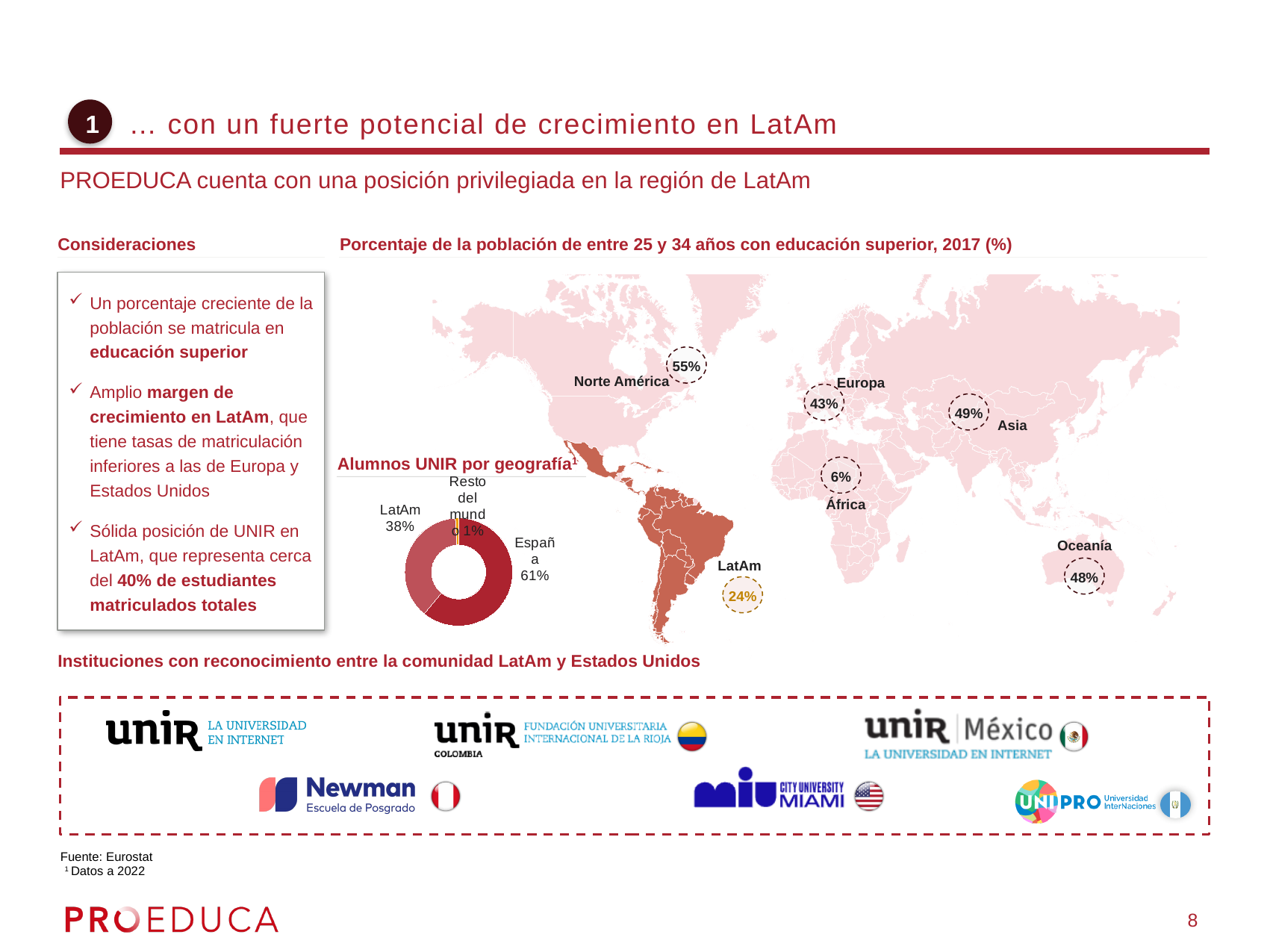
In the map 'Porcentaje de la población de entre 25 y 34 años con educación superior, 2017 (%)', which is higher, Europa or Asia? Asia In the 'Alumnos UNIR por geografía' chart, how many geographies are shown? 3 In the 'Alumnos UNIR por geografía' chart, what share of students is from LatAm? 38% In the map 'Porcentaje de la población de entre 25 y 34 años con educación superior, 2017 (%)', which region has the lowest value? África In the map 'Porcentaje de la población de entre 25 y 34 años con educación superior, 2017 (%)', what is the value for Norte América? 55% In the 'Alumnos UNIR por geografía' chart, what share of students is from España? 61% In the 'Alumnos UNIR por geografía' chart, what is the difference in percentage points between España and LatAm? 23 In the 'Alumnos UNIR por geografía' chart, which geography has the largest share? España In the map 'Porcentaje de la población de entre 25 y 34 años con educación superior, 2017 (%)', what is the value for LatAm? 24% In the 'Alumnos UNIR por geografía' chart, what share of students is from Resto del mundo? 1% What kind of chart is 'Alumnos UNIR por geografía'? Donut (pie) chart In the 'Alumnos UNIR por geografía' chart, which geography has the smallest share? Resto del mundo